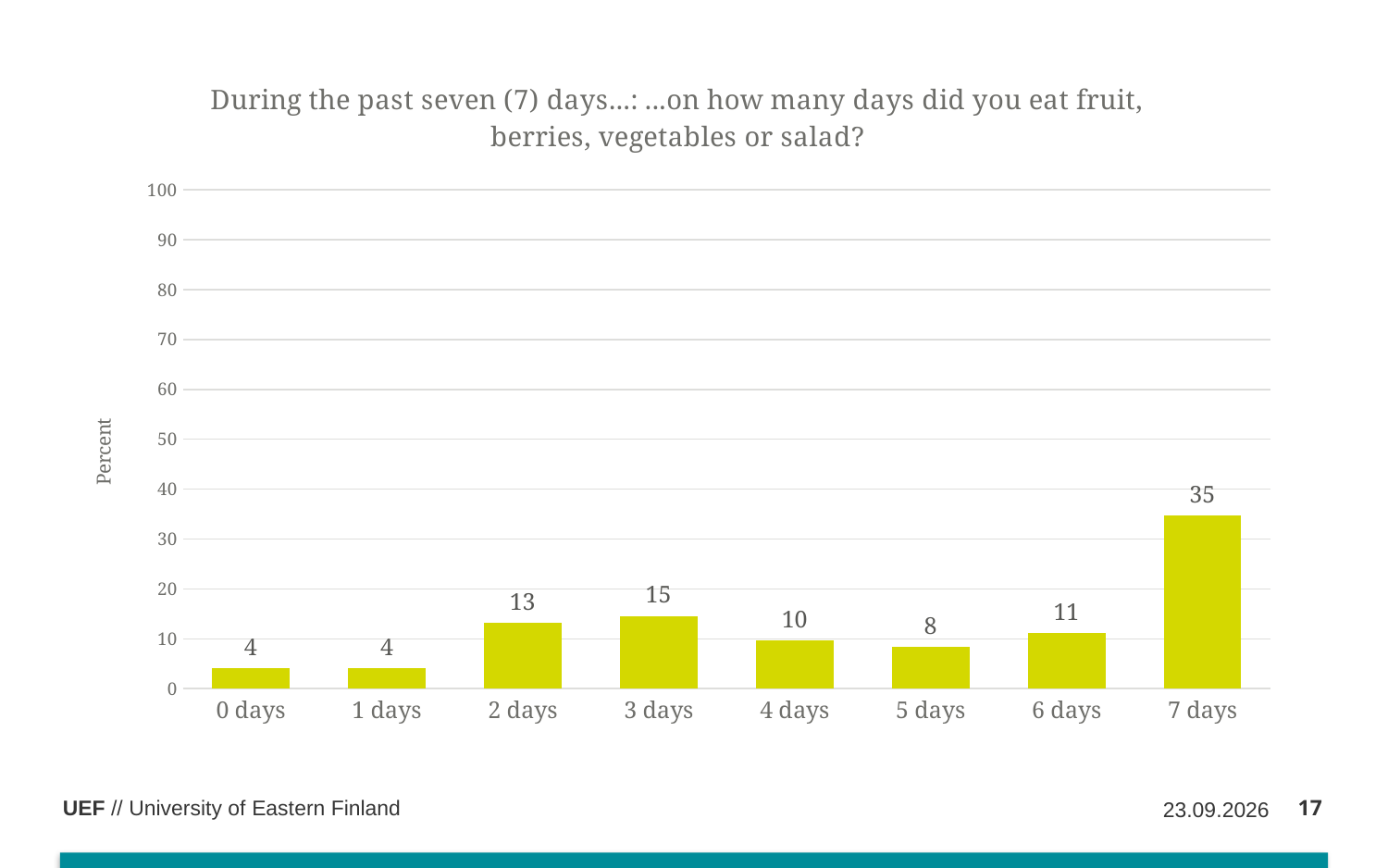
What is the label of the y axis? Percent What is the value for 1 days? 4 What is the difference between the values for 7 days and 3 days? 20 Which category has the highest value? 7 days What is the value for 5 days? 8 What percentage of respondents ate fruit, berries, vegetables or salad on 7 days? 35 What is the value for 3 days? 15 What is the difference between the values for 2 days and 0 days? 9 Which is larger, the value for 4 days or the value for 6 days? 6 days What kind of chart is shown on the slide? bar chart How many categories are shown on the x axis? 8 Is the value for 7 days greater or less than 30? greater